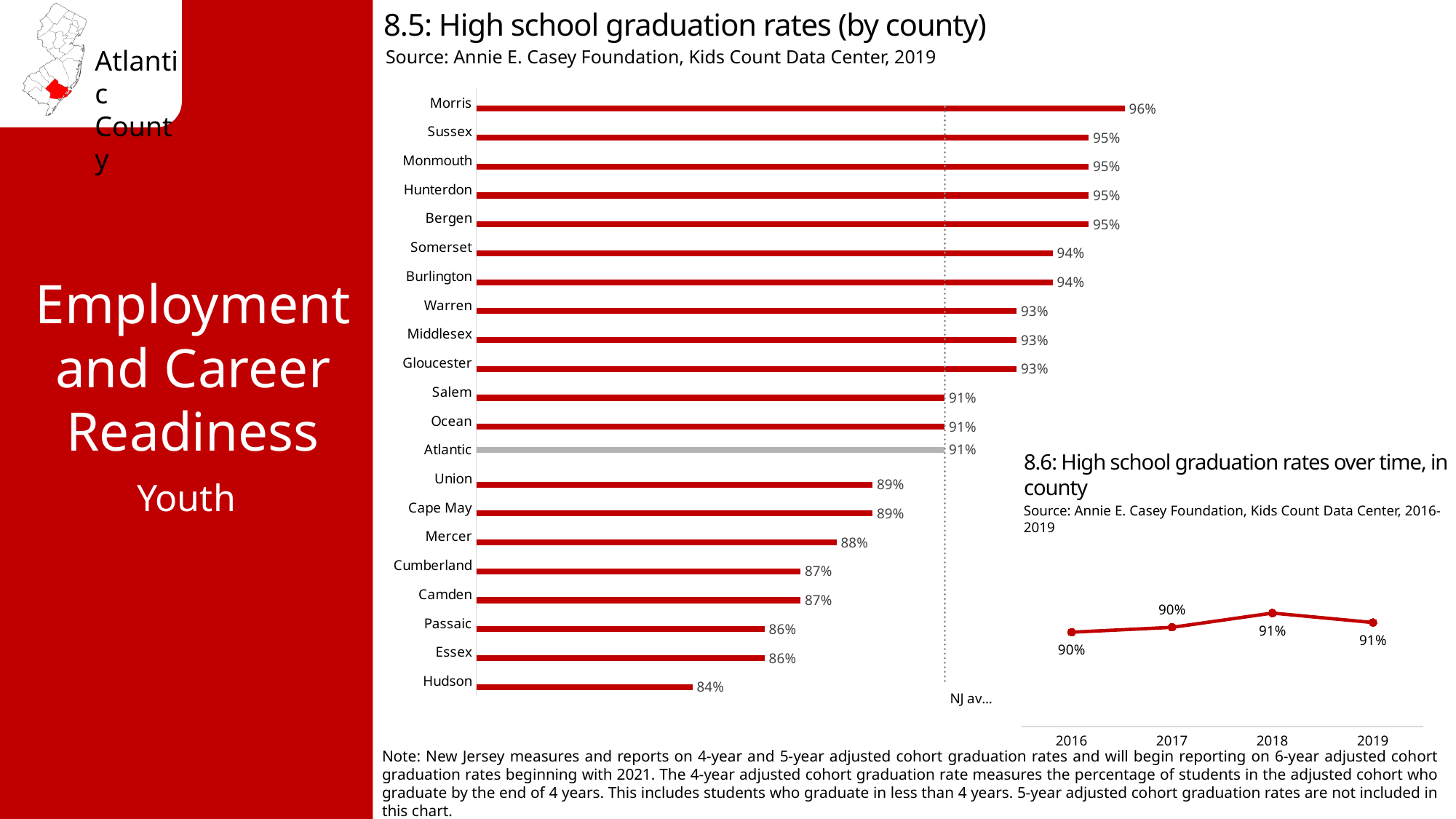
In chart 8.5 (High school graduation rates by county), what is the graduation rate for Hudson? 84% In chart 8.5 (High school graduation rates by county), which county has the highest graduation rate? Morris In chart 8.6 (High school graduation rates over time), what was the graduation rate in 2018? 91% What kind of chart is chart 8.6 (High school graduation rates over time)? Line chart In chart 8.5 (High school graduation rates by county), which county has the lowest graduation rate? Hudson In chart 8.6 (High school graduation rates over time), what was the graduation rate in 2016? 90% In chart 8.5 (High school graduation rates by county), what is the difference between the graduation rates of Morris and Hudson? 12 percentage points In chart 8.5 (High school graduation rates by county), which has a higher graduation rate, Mercer or Passaic? Mercer What kind of chart is chart 8.5 (High school graduation rates by county)? Bar chart In chart 8.5 (High school graduation rates by county), what is the graduation rate for Atlantic? 91% In chart 8.5 (High school graduation rates by county), how many counties are shown? 21 In chart 8.6 (High school graduation rates over time), how many years are plotted? 4